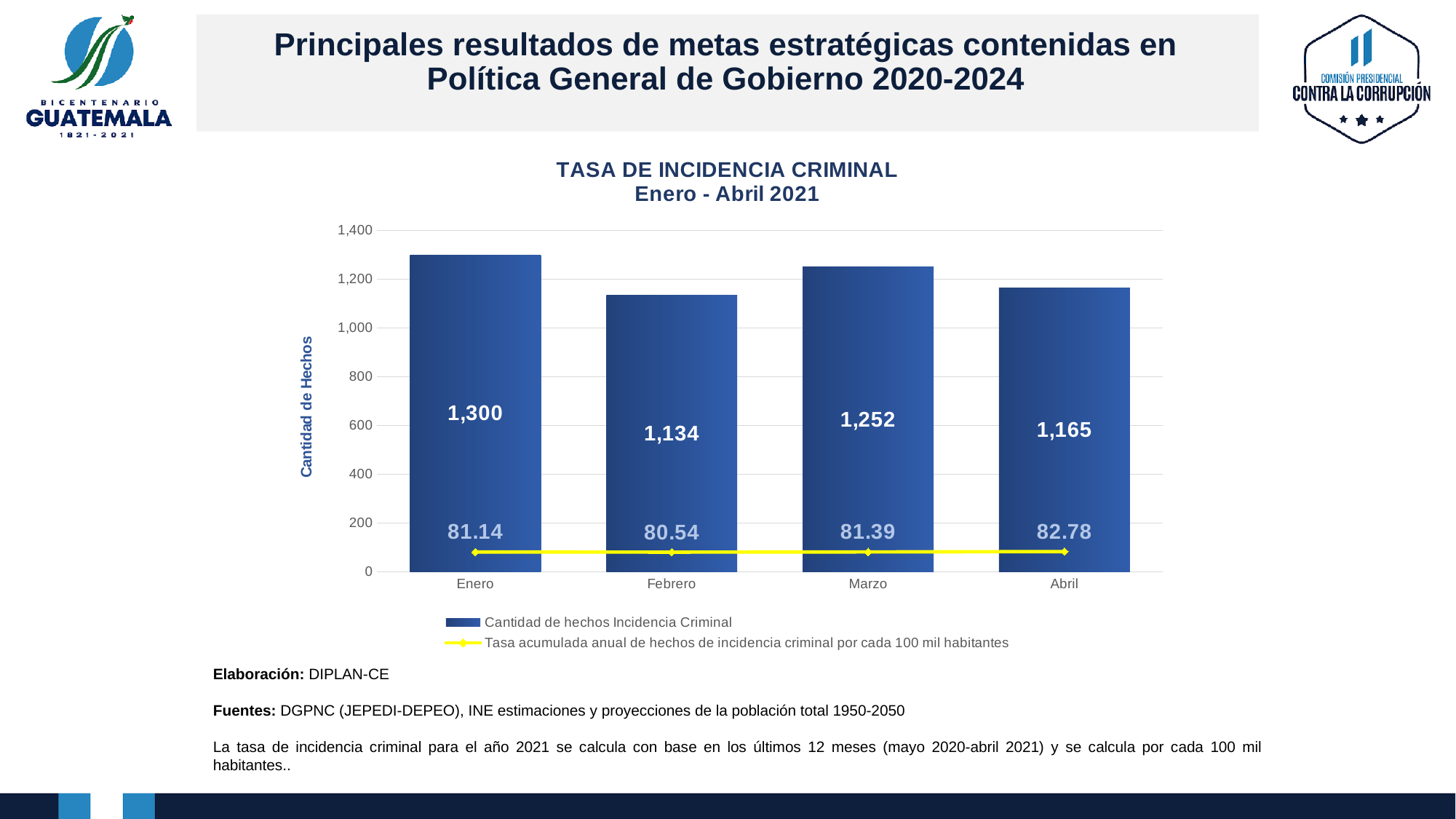
Which month has the lowest 'Tasa acumulada anual de hechos de incidencia criminal por cada 100 mil habitantes'? Febrero What is the difference in 'Cantidad de hechos Incidencia Criminal' between Enero and Febrero? 166 Which month has the lowest 'Cantidad de hechos Incidencia Criminal'? Febrero How many months are shown on the x axis of the chart? 4 What is the value of 'Cantidad de hechos Incidencia Criminal' for Enero? 1,300 What is the value of 'Cantidad de hechos Incidencia Criminal' for Febrero? 1,134 How many series does the chart legend list? 2 Which month has the highest 'Cantidad de hechos Incidencia Criminal'? Enero What is the title of the chart? TASA DE INCIDENCIA CRIMINAL Enero - Abril 2021 Which month has a higher 'Cantidad de hechos Incidencia Criminal', Marzo or Abril? Marzo What is the 'Tasa acumulada anual de hechos de incidencia criminal por cada 100 mil habitantes' for Abril? 82.78 What is the 'Tasa acumulada anual de hechos de incidencia criminal por cada 100 mil habitantes' for Marzo? 81.39